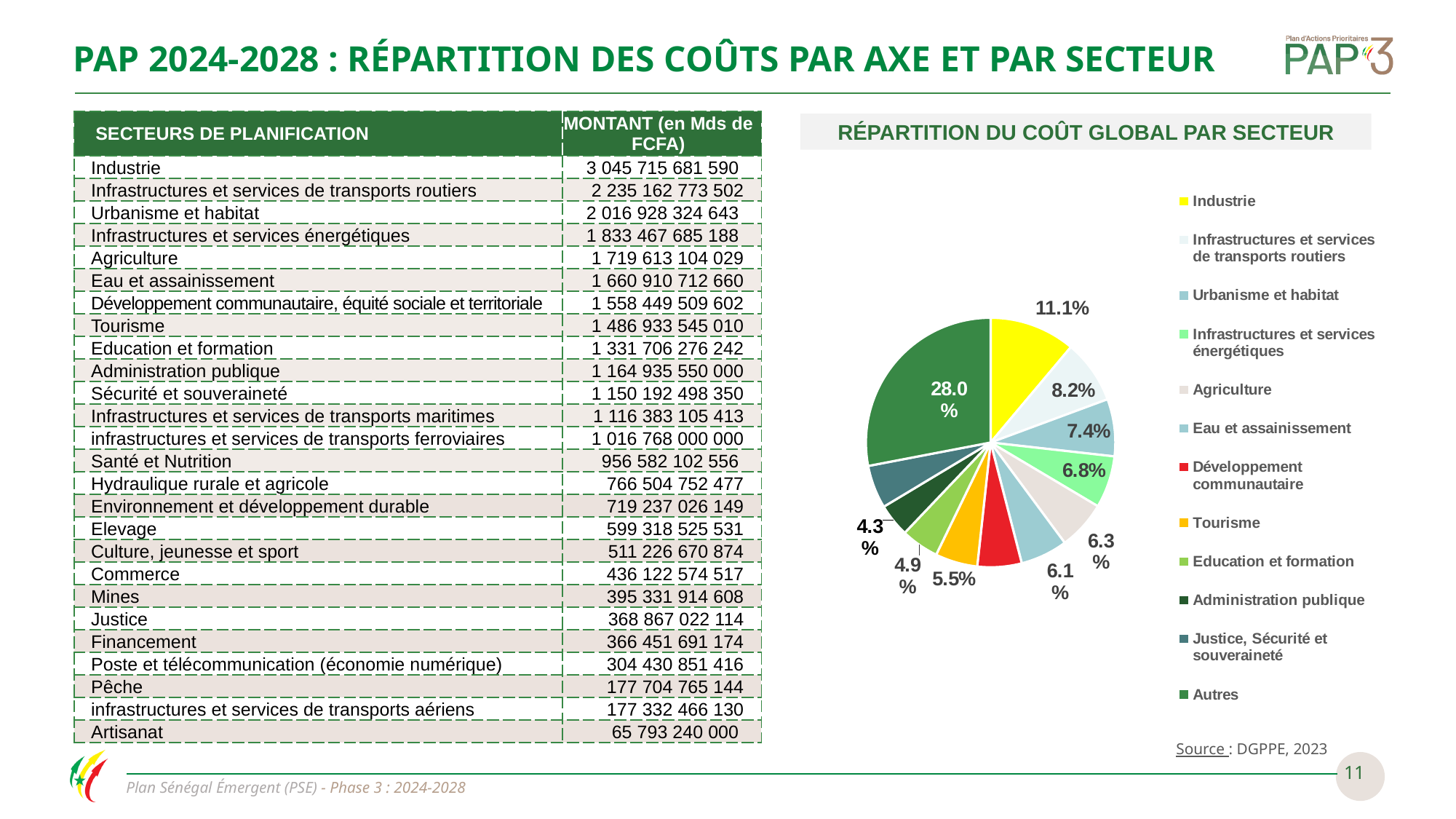
In the pie chart, what share is shown for Agriculture? 6.3% How many entries does the legend of the pie chart list? 12 What type of chart is shown under the heading 'RÉPARTITION DU COÛT GLOBAL PAR SECTEUR'? Pie chart In the pie chart, what share is shown for Industrie? 11.1% In the pie chart, what share is shown for Infrastructures et services énergétiques? 6.8% In the pie chart, what share is shown for Urbanisme et habitat? 7.4% What colour is the Industrie slice in the pie chart? Yellow In the pie chart, which has the larger share: Agriculture or Eau et assainissement? Agriculture In the pie chart, what is the difference in percentage points between the Industrie share and the Infrastructures et services de transports routiers share? 2.9 percentage points Which slice of the pie chart has the largest share? Autres In the pie chart, what share is shown for Tourisme? 5.5% In the pie chart, what share is shown for Autres? 28.0%